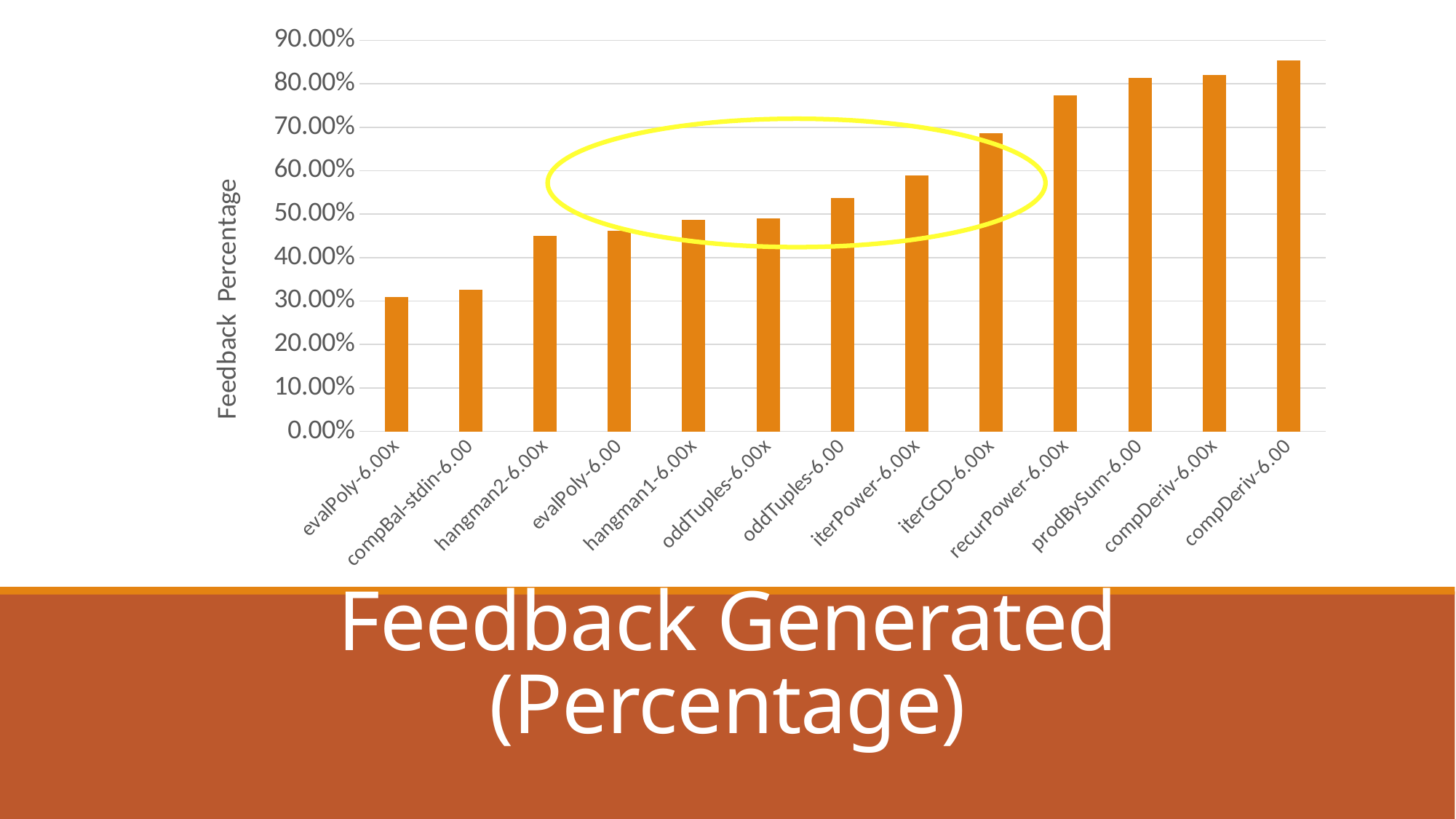
What is the label on the vertical axis of the chart? Feedback Percentage Which category has the highest feedback percentage? compDeriv-6.00 Is the value for iterGCD-6.00x greater or less than 60.00%? greater How many categories are plotted on the x axis of the chart? 13 Is the value for evalPoly-6.00x greater or less than 40.00%? less Is the value for hangman2-6.00x greater or less than 50.00%? less Do the bar values generally rise or fall from left to right along the x axis? rise What kind of chart is shown on the slide? bar chart Which category has the lowest feedback percentage? evalPoly-6.00x Which has a higher feedback percentage, hangman2-6.00x or oddTuples-6.00? oddTuples-6.00 Which has a higher feedback percentage, recurPower-6.00x or iterGCD-6.00x? recurPower-6.00x